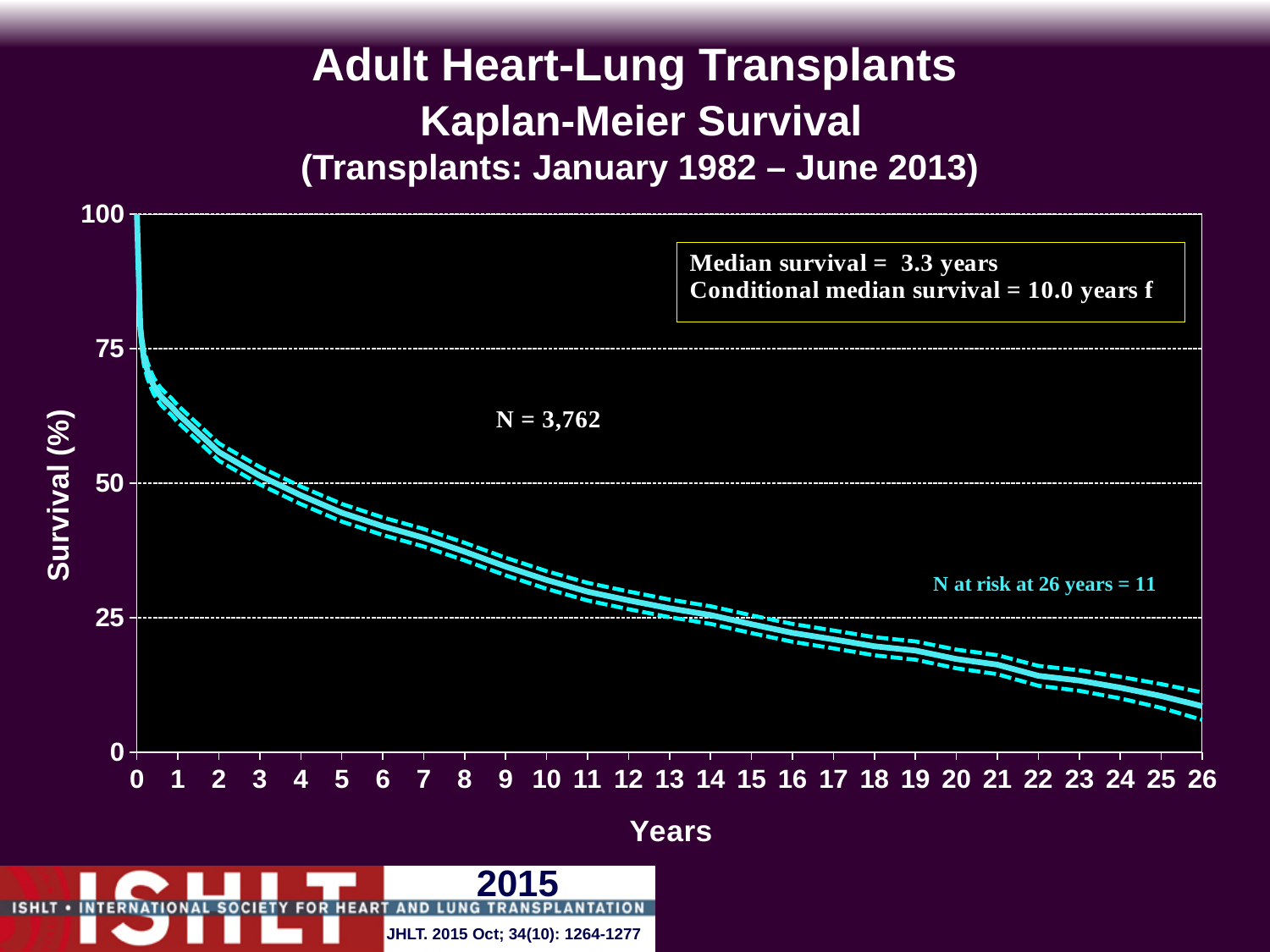
What is the highest value shown on the x axis (Years)? 26 What is the N at risk at 26 years? 11 What is the label of the y axis? Survival (%) Is the survival value at 26 years greater or less than 25? less What is the conditional median survival stated on the chart? 10.0 years What is the median survival stated on the chart? 3.3 years Is the survival value at 20 years greater or less than 25? less What is the value of N shown on the chart? 3,762 Is the survival value at 1 year greater or less than 50? greater What kind of chart is shown on the slide? line chart Does survival rise or fall as years increase along the x axis? fall